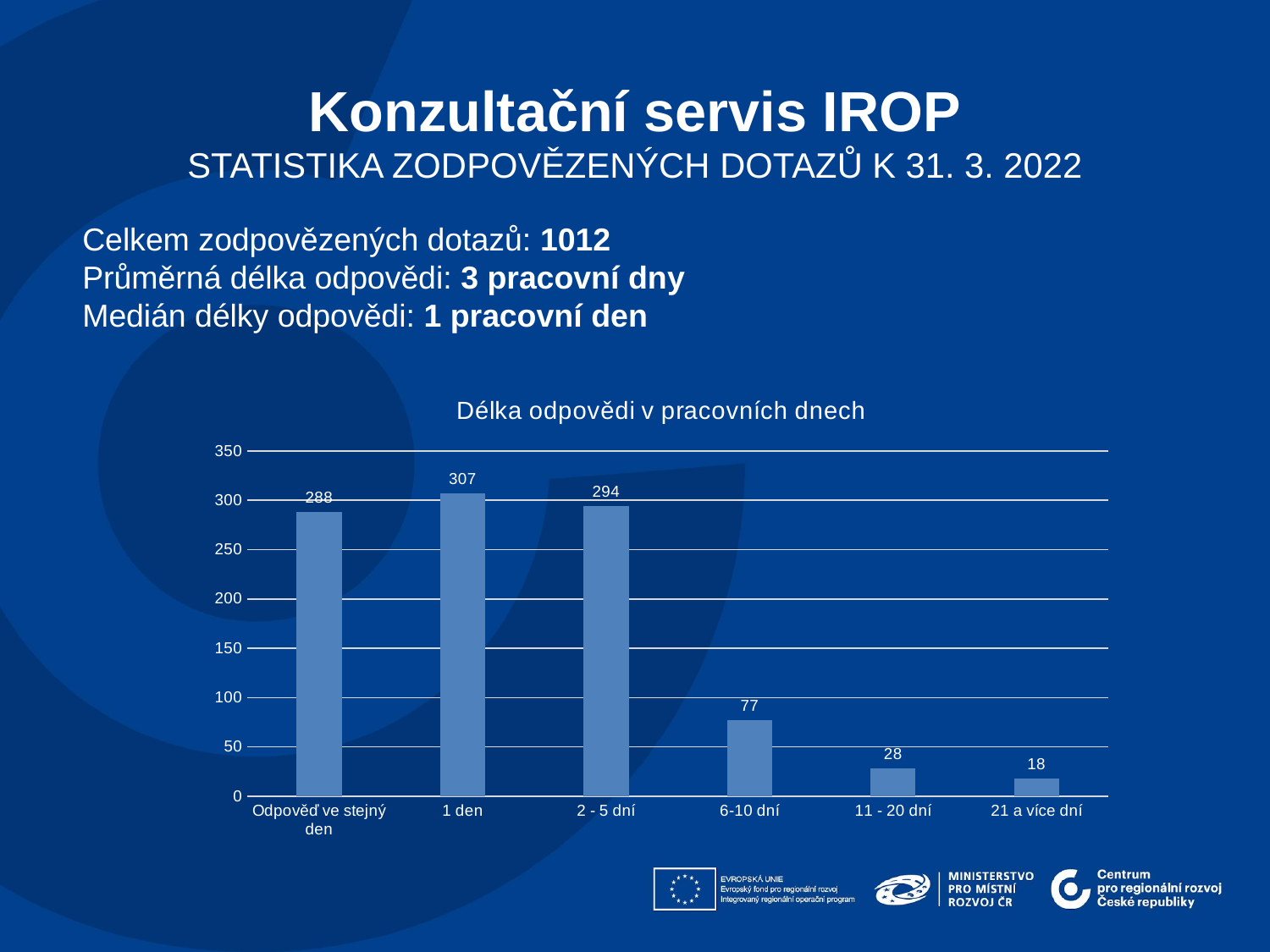
Which category has the lowest value in the chart? 21 a více dní What is the value for '6-10 dní' in the chart? 77 How many categories are shown on the x axis of the chart? 6 Which category has the highest value in the chart? 1 den What is the difference between the values for '1 den' and '2 - 5 dní'? 13 What is the value for '21 a více dní' in the chart? 18 Which is larger, the value for 'Odpověď ve stejný den' or the value for '2 - 5 dní'? 2 - 5 dní Is the value for '6-10 dní' greater or less than 100? less What kind of chart is shown on the slide? bar chart What is the title of the chart on the slide? Délka odpovědi v pracovních dnech What is the value for '1 den' in the chart 'Délka odpovědi v pracovních dnech'? 307 What is the difference between the values for '6-10 dní' and '11 - 20 dní'? 49